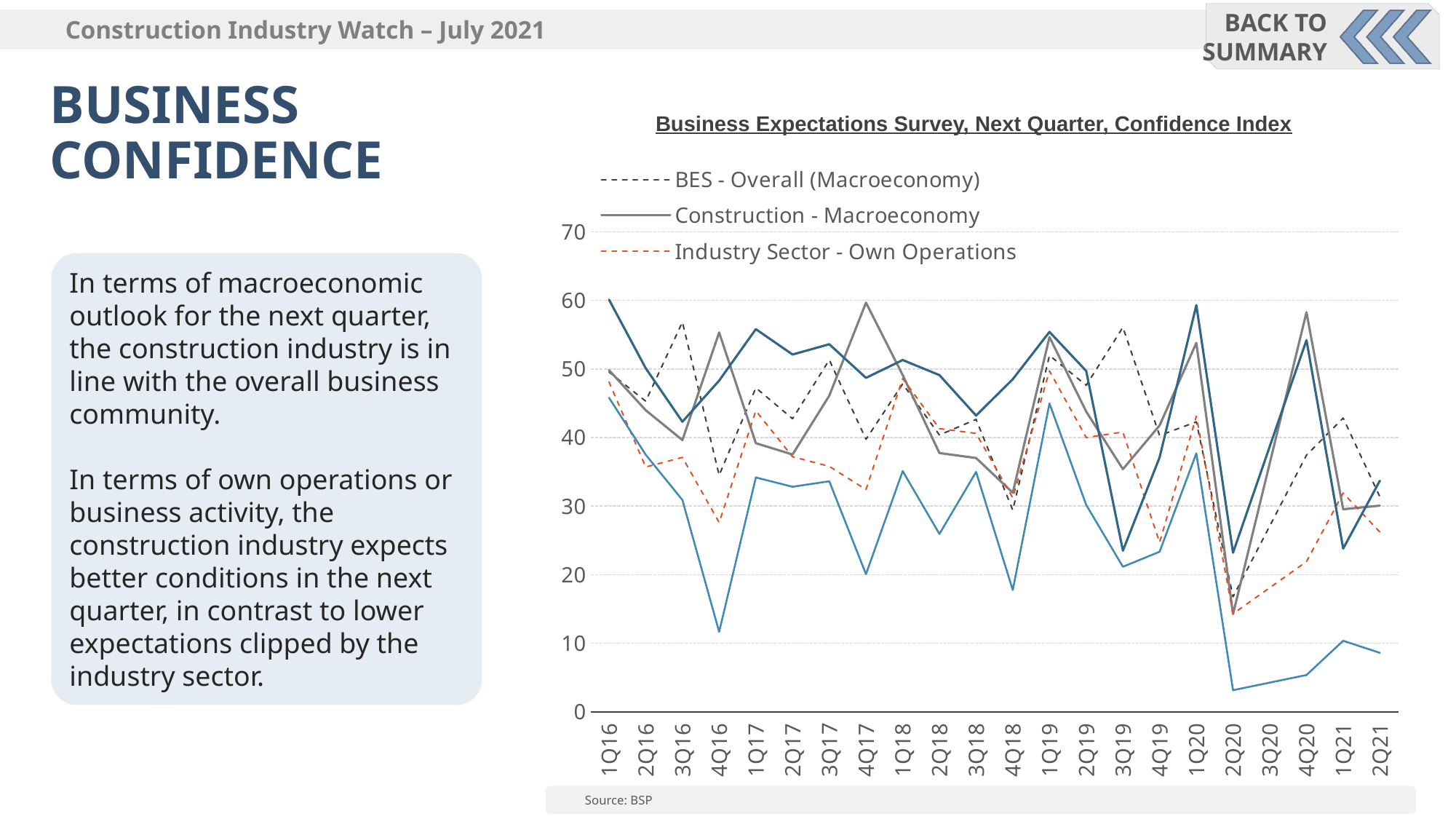
Is the value for Construction - Macroeconomy in 2Q20 greater or less than 20? less How many series does the chart legend list? 3 Is the value for Construction - Macroeconomy in 4Q17 greater or less than 50? greater What is the first quarter shown on the x axis? 1Q16 Does the Industry Sector - Own Operations series rise or fall from 2Q20 to 1Q21? rise In which quarter does the Construction - Macroeconomy series reach its lowest value? 2Q20 What is the title of the chart? Business Expectations Survey, Next Quarter, Confidence Index In which quarter does the Industry Sector - Own Operations series reach its lowest value? 2Q20 How many quarters are shown on the x axis of the chart? 22 Is the value for BES - Overall (Macroeconomy) in 3Q16 greater or less than 50? greater In 4Q16, which is higher: Construction - Macroeconomy or BES - Overall (Macroeconomy)? Construction - Macroeconomy What kind of chart is shown on the slide? line chart